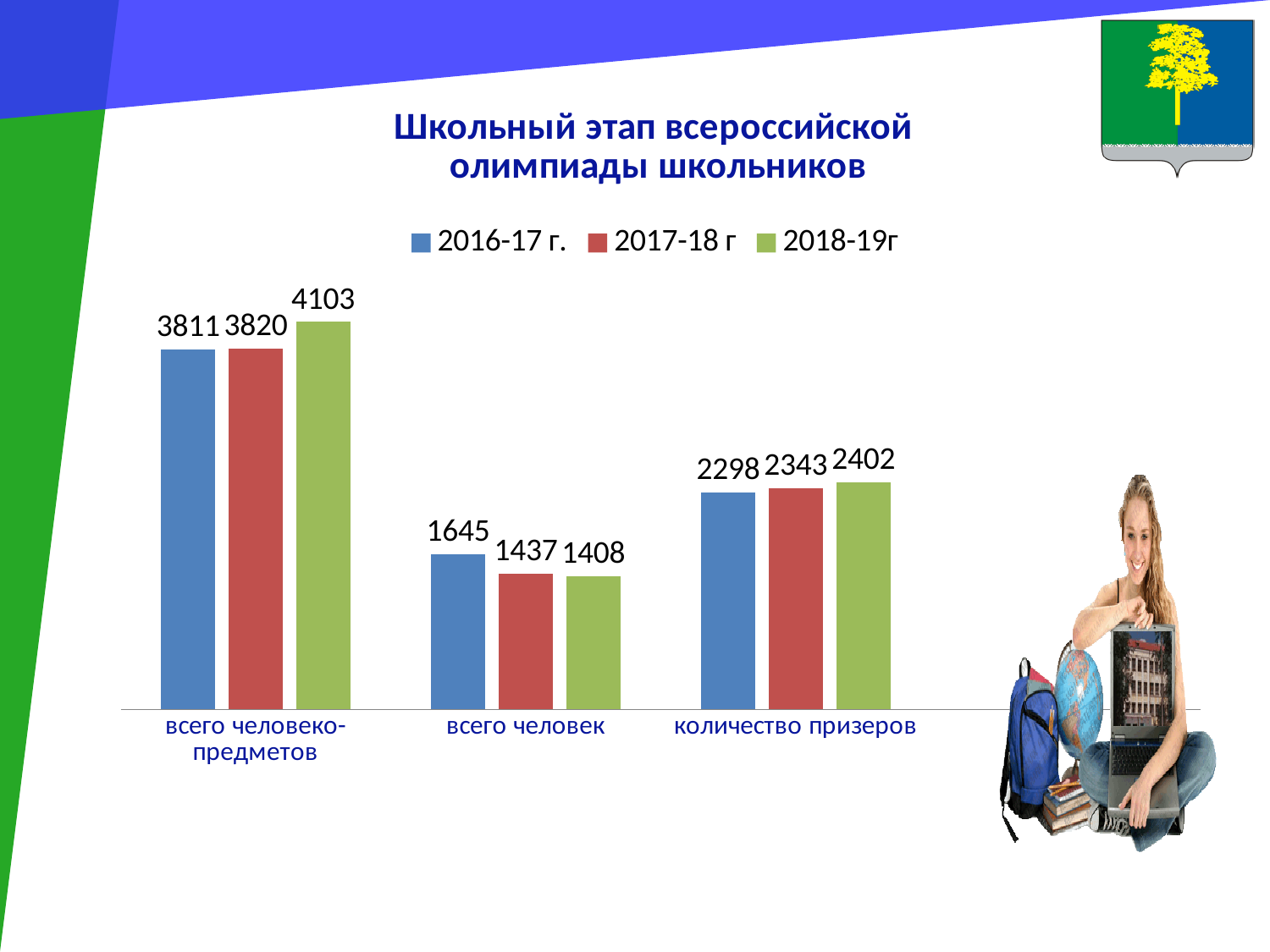
Which category has the lowest value for the 2018-19г series? всего человек How many series does the legend list? 3 How many categories are shown on the x axis? 3 In the category 'количество призеров', which series has the larger value: 2016-17 г. or 2018-19г? 2018-19г What is the value for 2018-19г in the category 'всего человеко-предметов'? 4103 What is the difference between the 2018-19г and 2016-17 г. values in the category 'всего человеко-предметов'? 292 What is the value for 2016-17 г. in the category 'всего человек'? 1645 Do the values in the category 'всего человек' rise or fall from 2016-17 г. to 2018-19г? fall What kind of chart is shown on the slide? bar chart Which category has the highest value for the 2016-17 г. series? всего человеко-предметов What is the value for 2017-18 г in the category 'количество призеров'? 2343 What is the difference between the 2016-17 г. and 2018-19г values in the category 'всего человек'? 237